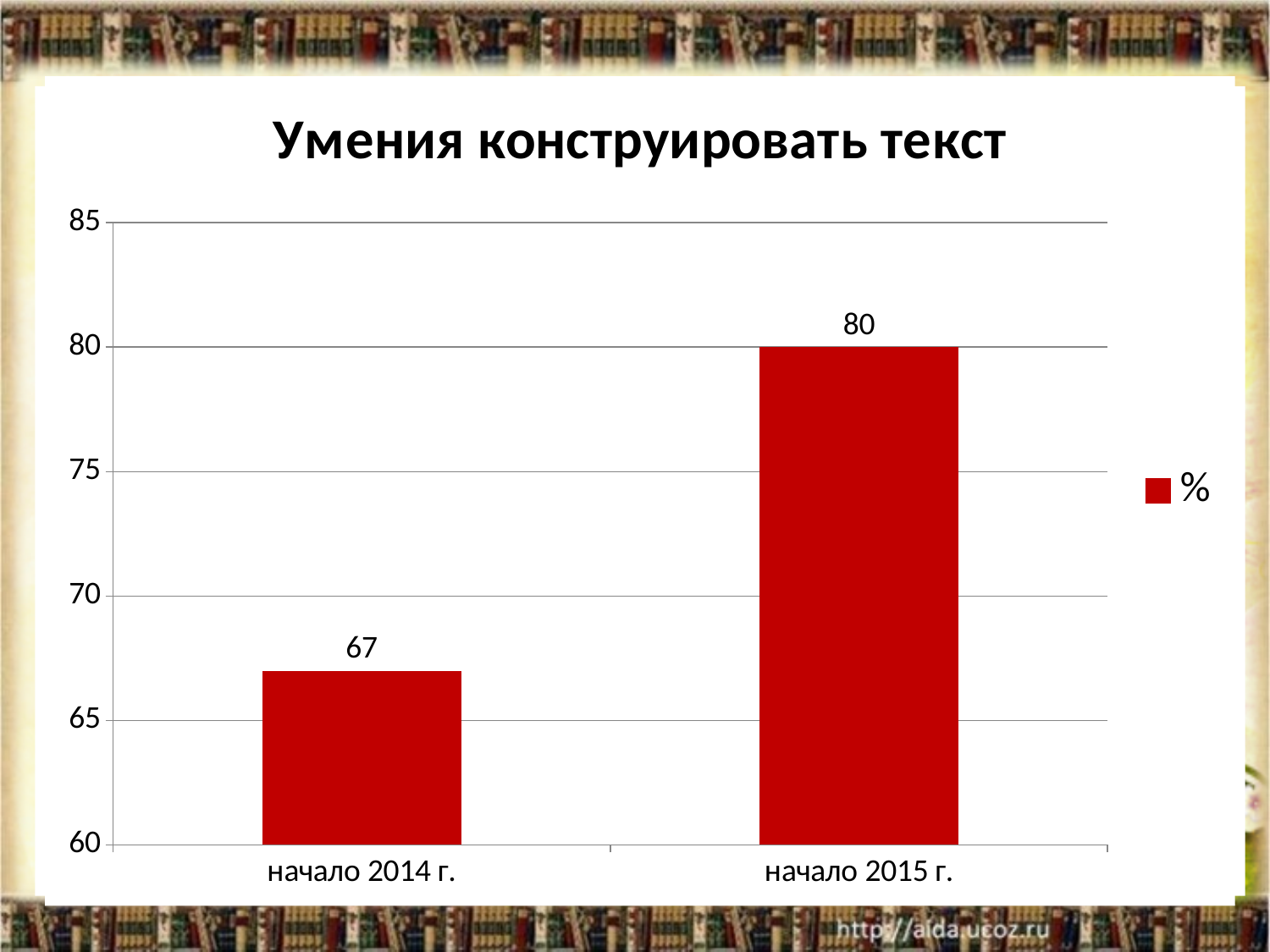
What is the difference between the values for начало 2015 г. and начало 2014 г.? 13 Is the value for начало 2015 г. greater or less than 75? greater What is the value for начало 2014 г.? 67 Which category has the lowest value? начало 2014 г. How many series does the legend list? 1 Which category has the highest value? начало 2015 г. Which is larger, the value for начало 2014 г. or the value for начало 2015 г.? начало 2015 г. What is the title of the chart? Умения конструировать текст Is the value for начало 2014 г. greater or less than 70? less What kind of chart is shown on the slide? bar chart What is the value for начало 2015 г.? 80 How many categories are shown on the x axis? 2